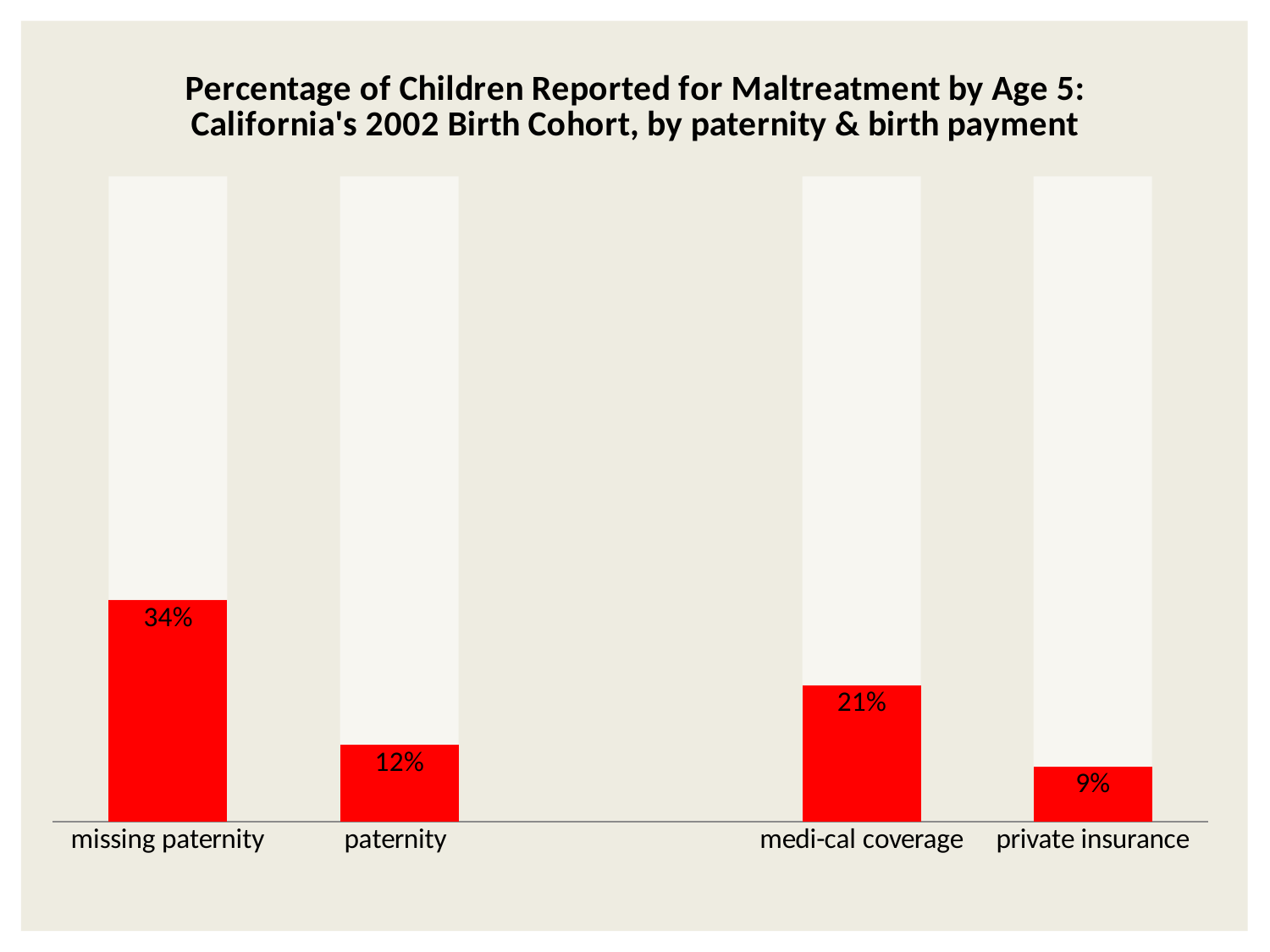
What is the value shown for the paternity category? 12% Which is larger, the value for medi-cal coverage or the value for paternity? medi-cal coverage Which category has the lowest percentage? private insurance What kind of chart is shown on the slide? bar chart Which category has the highest percentage of children reported for maltreatment? missing paternity What percentage is shown for medi-cal coverage? 21% What percentage of children with missing paternity were reported for maltreatment by age 5? 34% What is the value for private insurance? 9% What is the difference between the medi-cal coverage and private insurance percentages? 12% What colour are the bars showing the percentages? red How many labelled categories are shown on the chart? 4 What is the difference between the missing paternity and paternity percentages? 22%